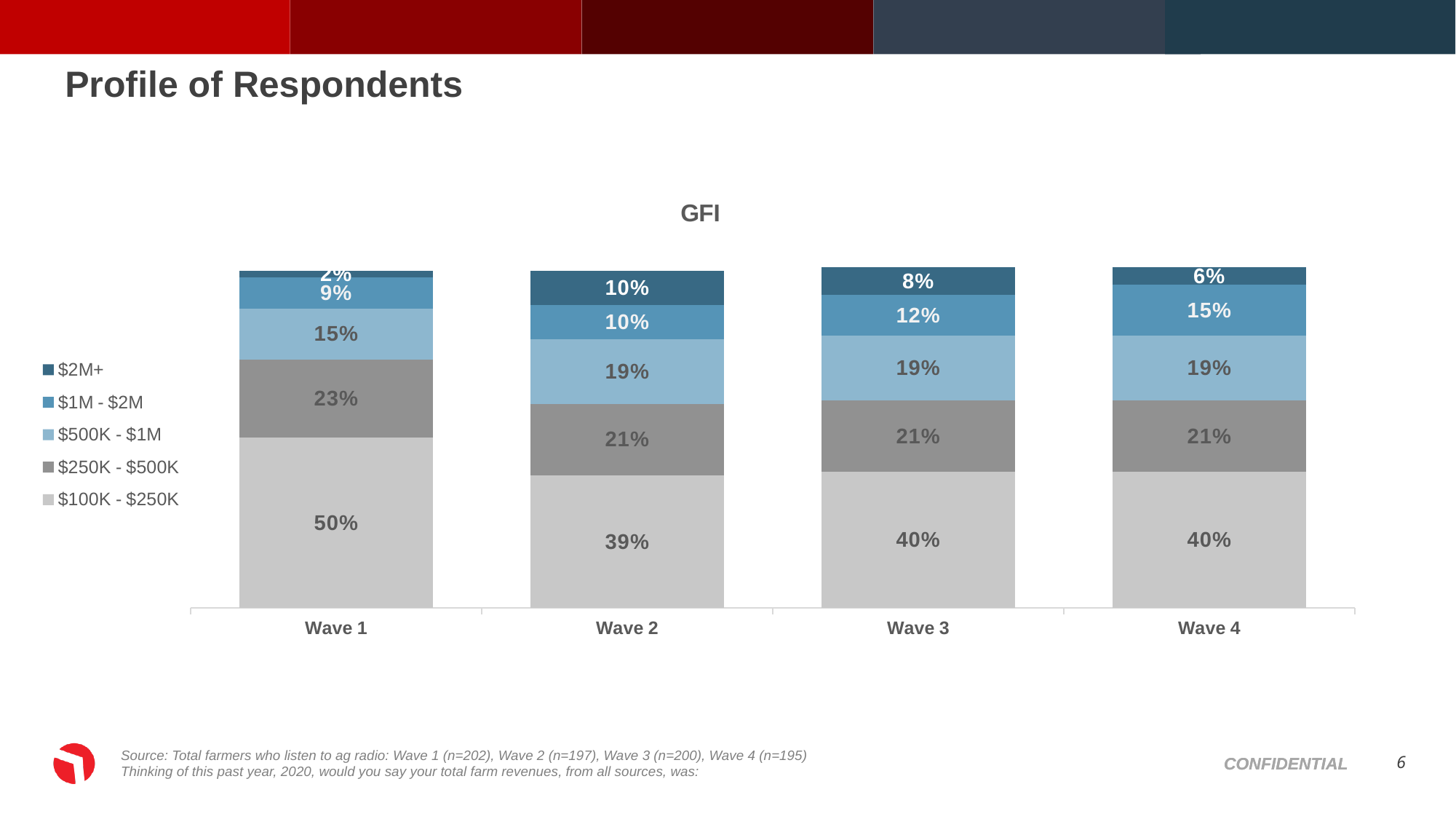
What is the value for $1M - $2M in Wave 4? 15% What type of chart is shown on the slide? Stacked bar chart How many series does the legend list? 5 Which is larger: the $1M - $2M value in Wave 3 or in Wave 4? Wave 4 What is the value for $100K - $250K in Wave 1? 50% Which wave has the lowest value for $2M+? Wave 1 What is the value for $250K - $500K in Wave 3? 21% What is the value for $2M+ in Wave 2? 10% What is the difference between the $100K - $250K values for Wave 1 and Wave 2? 11% What is the title of the chart? GFI Which wave has the highest value for $100K - $250K? Wave 1 How many waves are shown on the x axis? 4